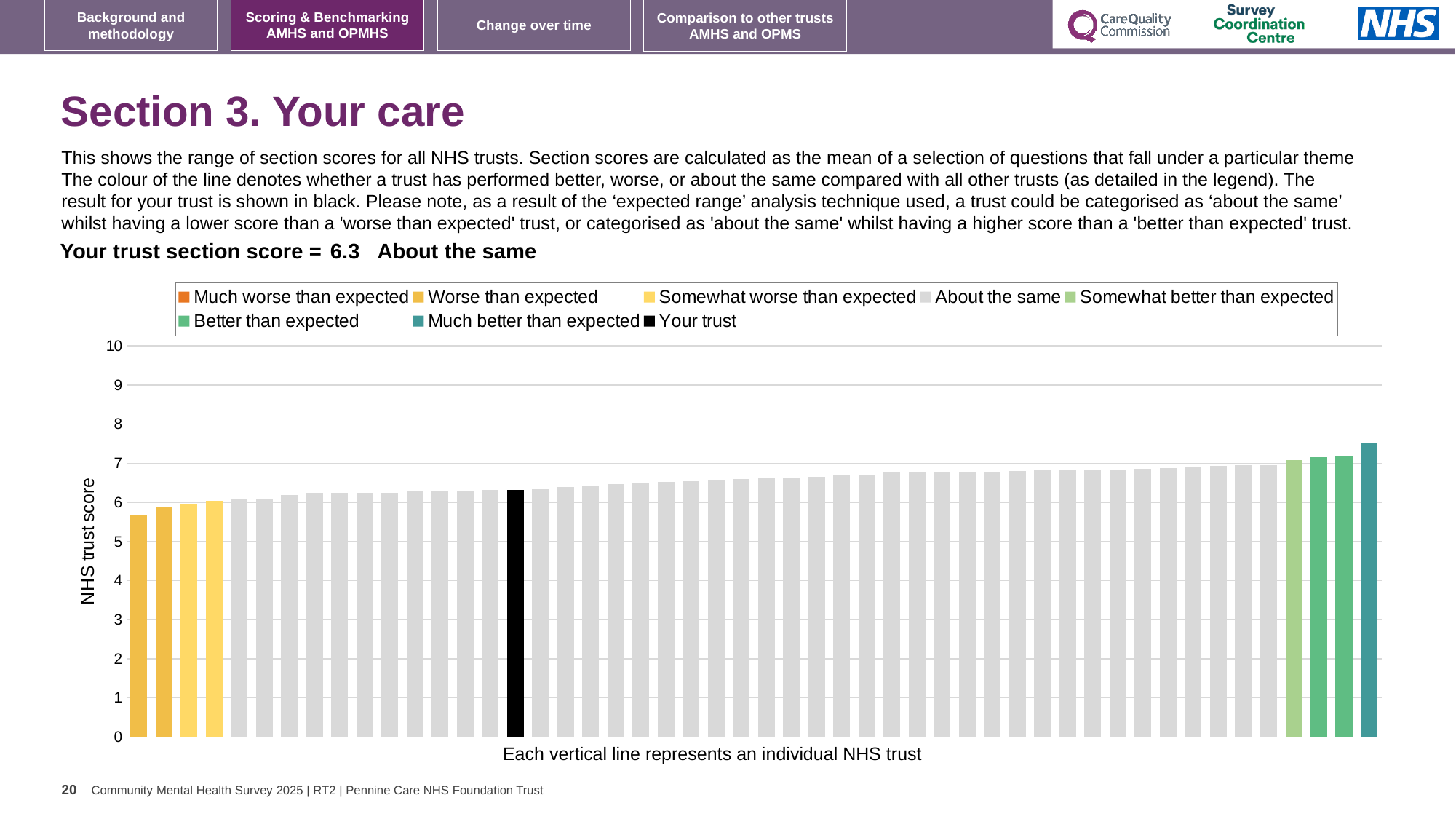
What kind of chart is shown on the slide? bar chart Is the value of the lowest bar greater or less than 5? greater Do the bar values rise or fall from left to right along the x axis? rise Is the value of the highest bar greater or less than 7? greater What is the label on the vertical axis of the chart? NHS trust score What is the section score for your trust shown on the slide? 6.3 What colour is the bar representing your trust? black Which category is your trust placed in for this section? About the same Is the value of the lowest bar greater or less than 6? less How many entries does the chart legend list? 8 Which bar is the highest: the leftmost or the rightmost? rightmost